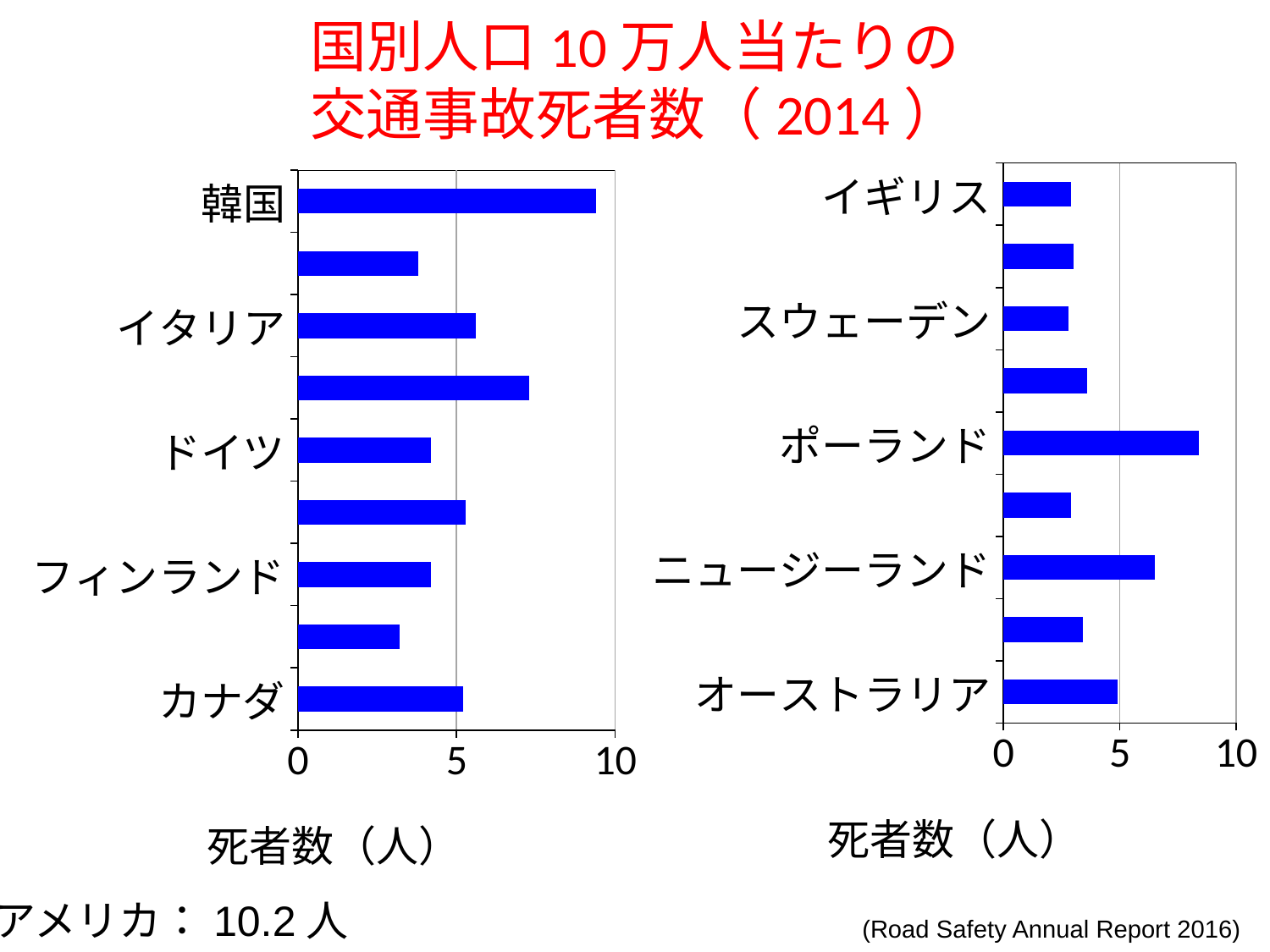
How many bars are plotted in the right chart? 9 In the left chart, which labeled country has the highest number of traffic fatalities per 100,000 people? 韓国 What kind of chart is the left chart on the slide? bar chart In the right chart, is the value for イギリス greater or less than 5? less In the left chart, which has the larger value, 韓国 or イタリア? 韓国 What year is given in the slide title for the traffic fatality data? 2014 What is the x-axis label of the left chart? 死者数（人） In the right chart, is the value for ニュージーランド greater or less than 5? greater In the left chart, is the value for 韓国 greater or less than 5? greater In the right chart, which has the larger value, ポーランド or スウェーデン? ポーランド In the right chart, which labeled country has the highest number of traffic fatalities per 100,000 people? ポーランド